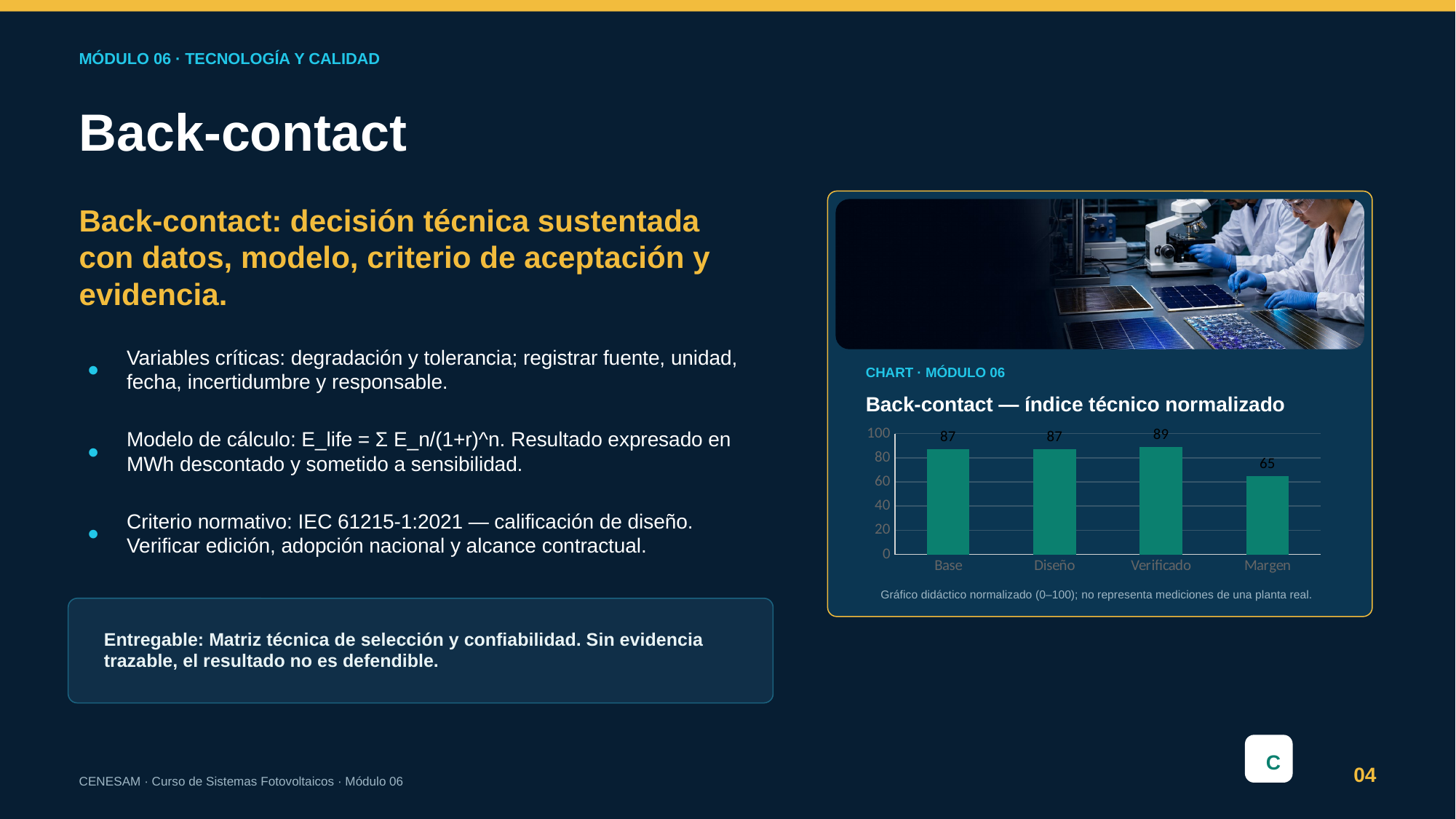
Which category has the lowest value? Margen What kind of chart is shown? bar chart What is the difference between the values for Verificado and Margen? 24 What is the difference between the values for Verificado and Diseño? 2 Which category has the highest value? Verificado What is the value for Base? 87 Which is larger, the value for Diseño or the value for Margen? Diseño What is the title of the chart? Back-contact — índice técnico normalizado How many categories are shown on the x axis? 4 What is the value for Margen? 65 What is the value for Verificado? 89 Is the value for Margen greater or less than 80? less